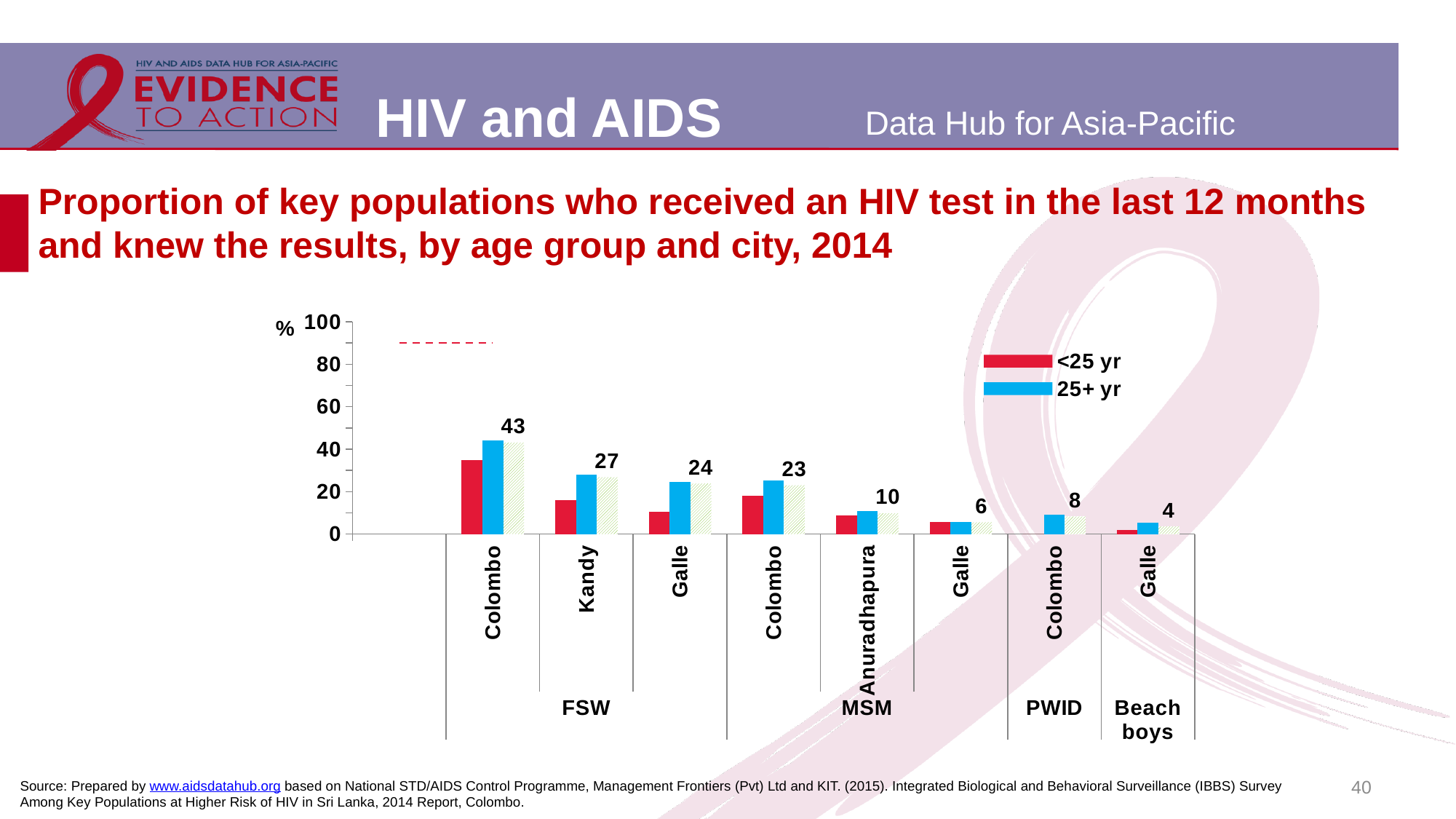
What are the two series named in the legend? <25 yr and 25+ yr Which city and group has the lowest printed data label? Galle (Beach boys) How many key population groups are labelled along the x axis? 4 Is the <25 yr value for Kandy in the FSW group greater or less than 20? less Which city and group has the highest printed data label? Colombo (FSW) What data label is printed above the bars for Kandy in the FSW group? 27 How many series does the chart legend list? 2 What data label is printed above the bars for Anuradhapura in the MSM group? 10 What data label is printed above the bars for Galle in the Beach boys group? 4 What kind of chart is shown on the slide? bar chart What data label is printed above the bars for Colombo in the FSW group? 43 For Colombo in the FSW group, which age group has the taller bar, <25 yr or 25+ yr? 25+ yr